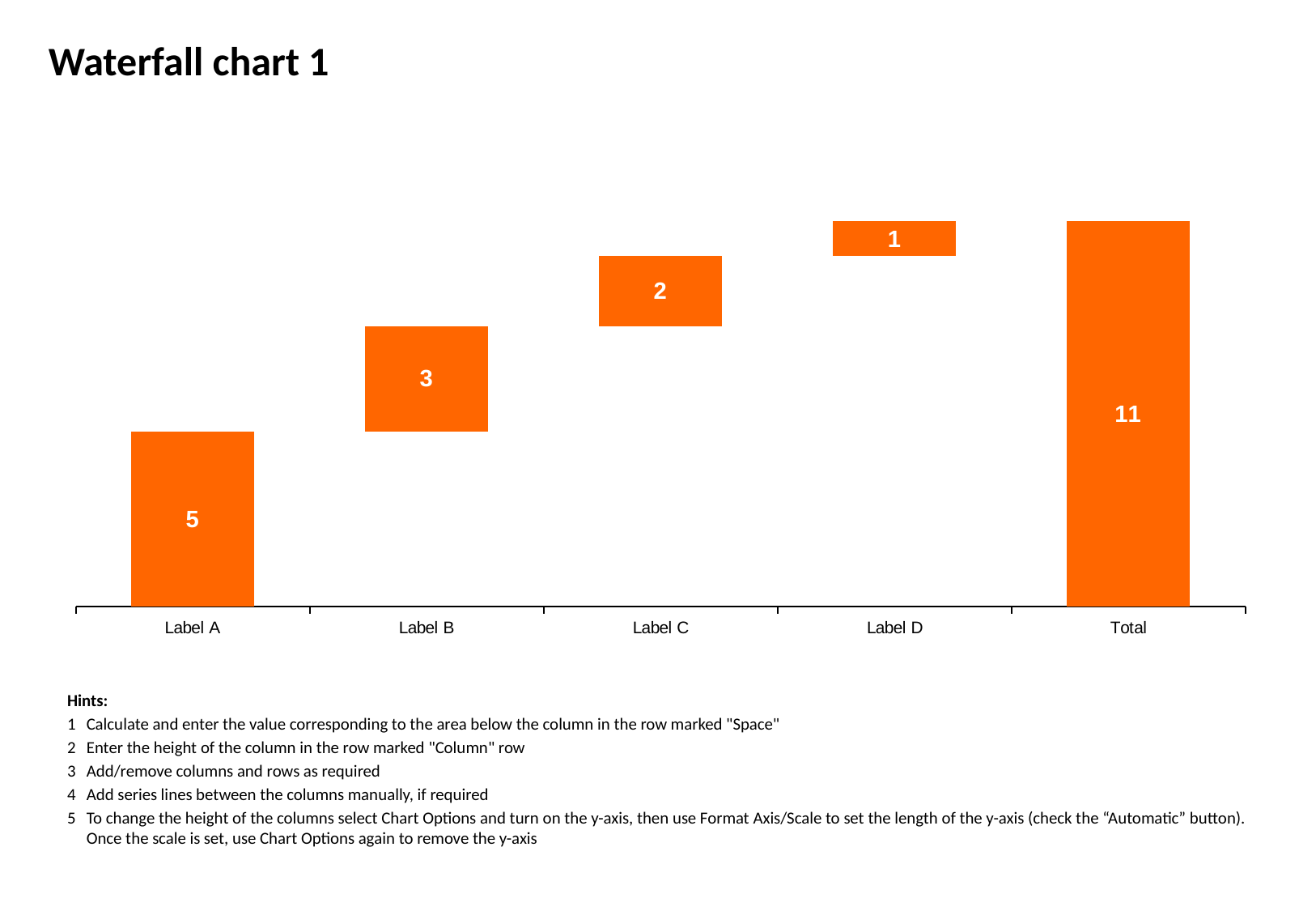
What is the value shown for Label B? 3 What is the value shown for Label D? 1 What is the value shown for Label A? 5 What kind of chart is shown on the slide? Waterfall chart (bar chart) How many categories are shown on the x axis? 5 Which is larger, the value for Label B or the value for Label C? Label B What is the difference between the values for Label A and Label B? 2 What is the title of the slide? Waterfall chart 1 What is the value shown for the Total bar? 11 Which category has the highest value on the chart? Total What is the value shown for Label C? 2 Which category has the lowest value on the chart? Label D